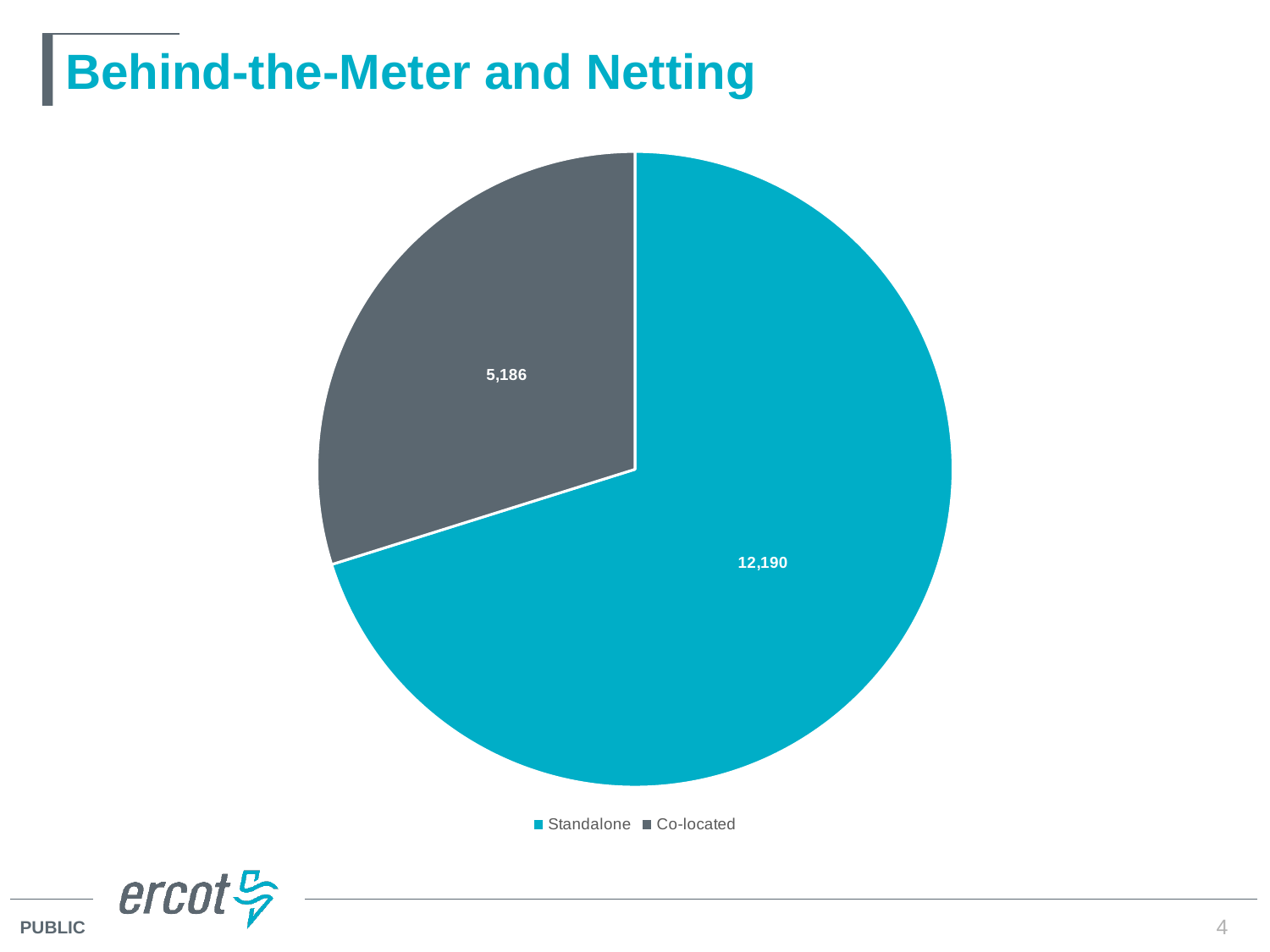
How many slices does the pie chart have? 2 Which category has the largest slice in the pie chart? Standalone Which category has the smallest slice in the pie chart? Co-located What value is shown for the Standalone slice of the pie chart? 12,190 What is the title of the slide containing the pie chart? Behind-the-Meter and Netting To the nearest whole percent, what share of the pie does the Standalone slice represent? 70% How many entries does the legend of the pie chart list? 2 What value is shown for the Co-located slice of the pie chart? 5,186 Which is larger, the Standalone value or the Co-located value? Standalone What kind of chart is shown on the slide? Pie chart What is the difference between the Standalone value and the Co-located value? 7,004 What is the total of the two values shown in the pie chart? 17,376